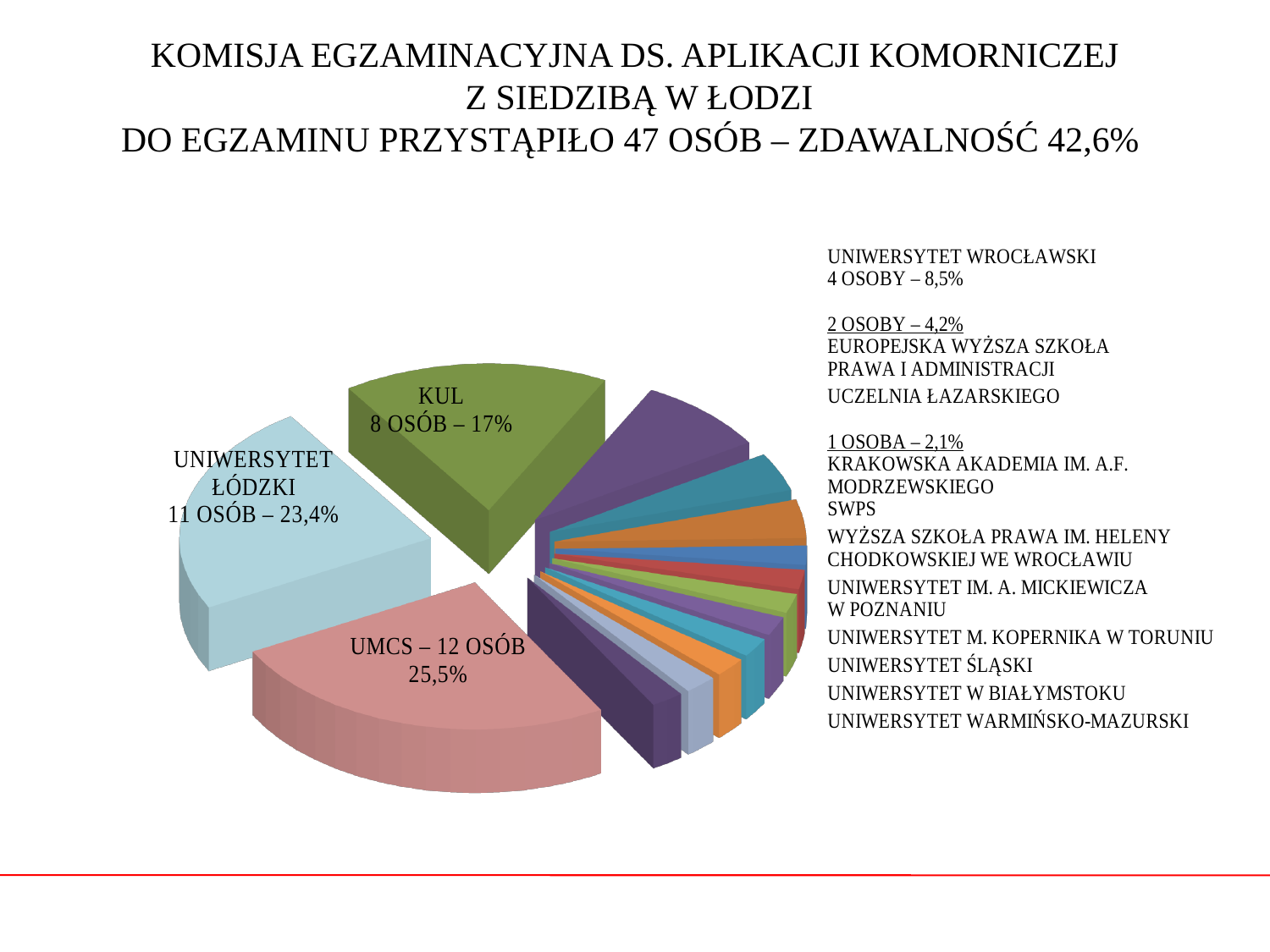
Which slice is larger, UMCS or UNIWERSYTET ŁÓDZKI? UMCS What colour is the KUL slice of the pie? green How many people does the UNIWERSYTET ŁÓDZKI slice represent? 11 OSÓB What kind of chart is shown on the slide? pie chart What share of the pie does the UMCS slice represent? 25,5% What is the difference in percentage points between the UNIWERSYTET ŁÓDZKI slice and the KUL slice? 6,4 What percentage is shown for UNIWERSYTET ŁÓDZKI? 23,4% Which university has the largest slice of the pie? UMCS How many more people does UMCS have than KUL? 4 What percentage is shown for the KUL slice? 17% How many people does the UMCS slice represent? 12 OSÓB Which slice is larger, KUL or UNIWERSYTET ŁÓDZKI? UNIWERSYTET ŁÓDZKI